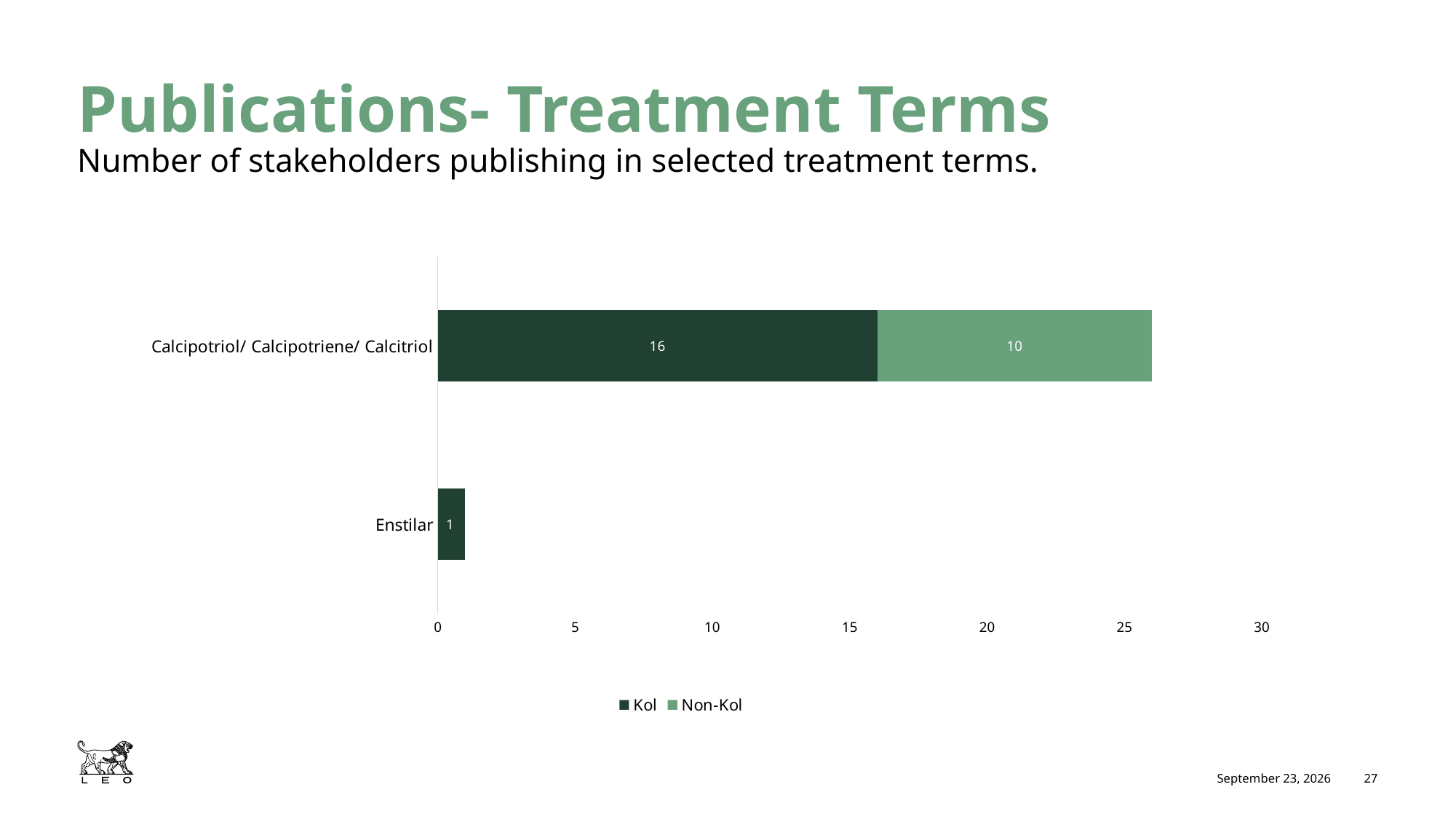
What is the Non-Kol value for Calcipotriol/ Calcipotriene/ Calcitriol? 10 Which treatment term has the lowest Kol value? Enstilar How many treatment terms are shown on the chart? 2 What is the total of the stacked bar for Calcipotriol/ Calcipotriene/ Calcitriol? 26 How many series does the legend list? 2 What are the two series named in the legend? Kol and Non-Kol What is the Kol value for Enstilar? 1 What is the difference between the Kol and Non-Kol values for Calcipotriol/ Calcipotriene/ Calcitriol? 6 Which treatment term has the highest Kol value? Calcipotriol/ Calcipotriene/ Calcitriol What kind of chart is shown on the slide? Stacked bar chart Which is larger: the Kol value for Calcipotriol/ Calcipotriene/ Calcitriol or the Kol value for Enstilar? Calcipotriol/ Calcipotriene/ Calcitriol What is the Kol value for Calcipotriol/ Calcipotriene/ Calcitriol? 16